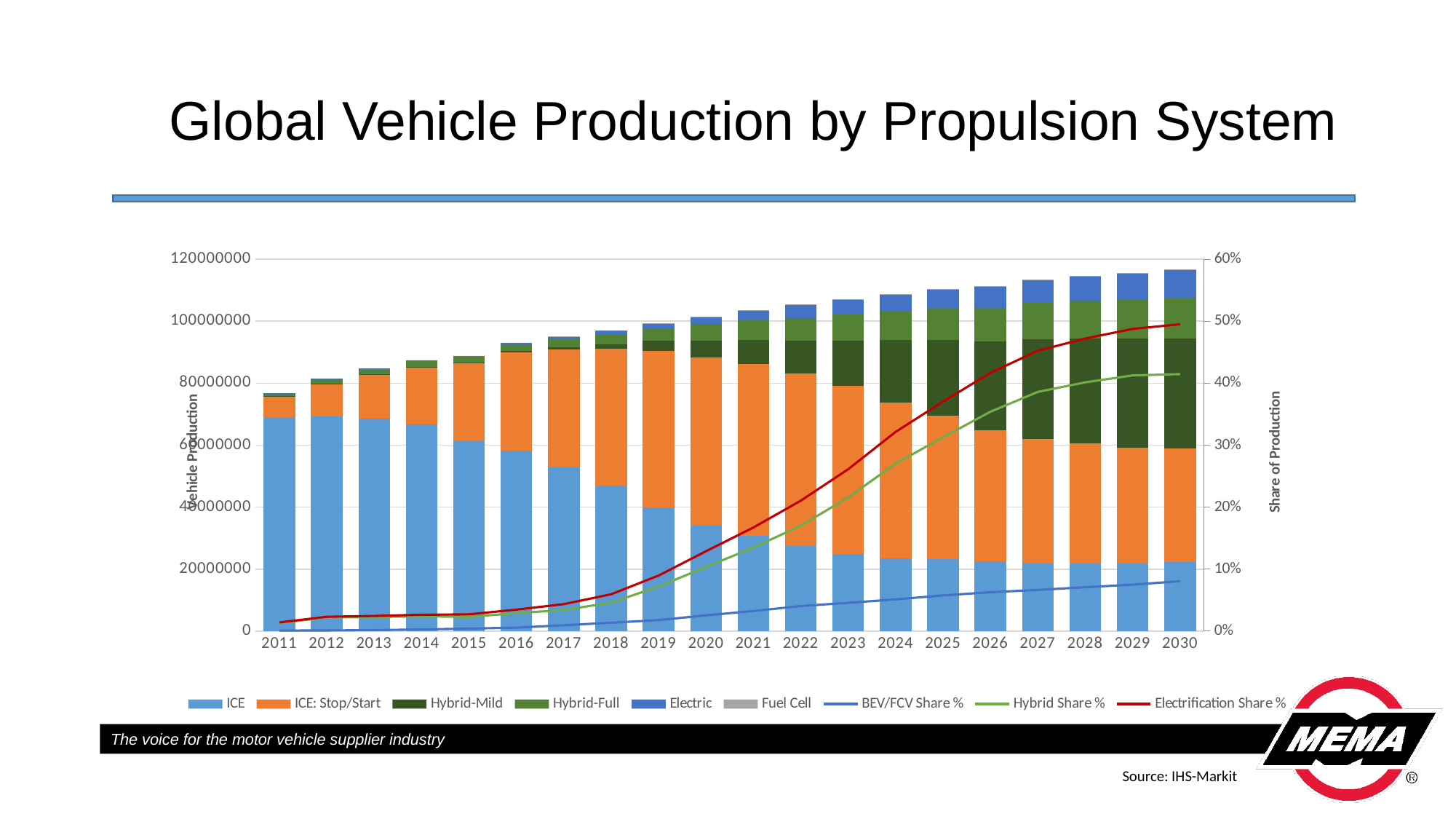
In 2030, which line is higher: Electrification Share % or Hybrid Share %? Electrification Share % How many years are shown along the x axis? 20 What is the title of the chart? Global Vehicle Production by Propulsion System Does the ICE (light blue) segment of the bars grow or shrink from 2011 to 2030? Shrinks Is the total vehicle production bar for 2030 greater or less than 100000000? greater How many series does the chart legend list? 9 Which year has the tallest total production bar? 2030 What kind of chart is shown on the slide? Stacked bar chart combined with line series Is the BEV/FCV Share % value for 2030 greater or less than 10%? less Does the Electrification Share % line rise or fall from 2011 to 2030? Rises Which year has the shortest total production bar? 2011 Is the Electrification Share % value for 2030 greater or less than 40%? greater